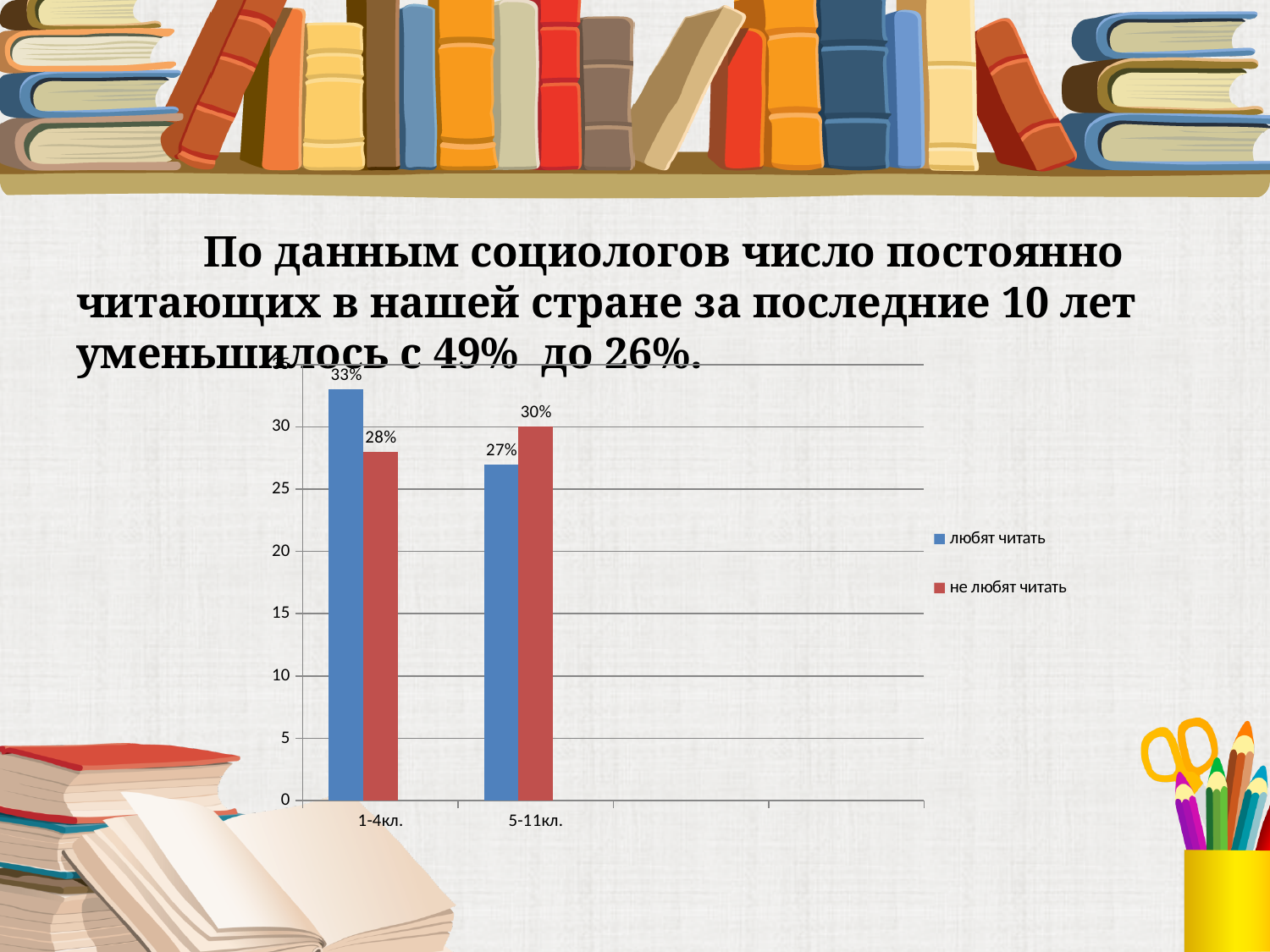
How many categories are shown on the x axis of the chart? 2 Which colour represents the "не любят читать" series in the chart? red In the "5-11кл." category, which is larger: "любят читать" or "не любят читать"? не любят читать How many series does the chart legend list? 2 Which category has the highest value for "любят читать"? 1-4кл. What is the value for "любят читать" in the "5-11кл." category? 27% What kind of chart is shown on the slide? bar chart What is the difference between "любят читать" and "не любят читать" in the "1-4кл." category? 5% What is the value for "любят читать" in the "1-4кл." category? 33% What is the value for "не любят читать" in the "5-11кл." category? 30% What is the value for "не любят читать" in the "1-4кл." category? 28% Which category has the lowest value for "не любят читать"? 1-4кл.